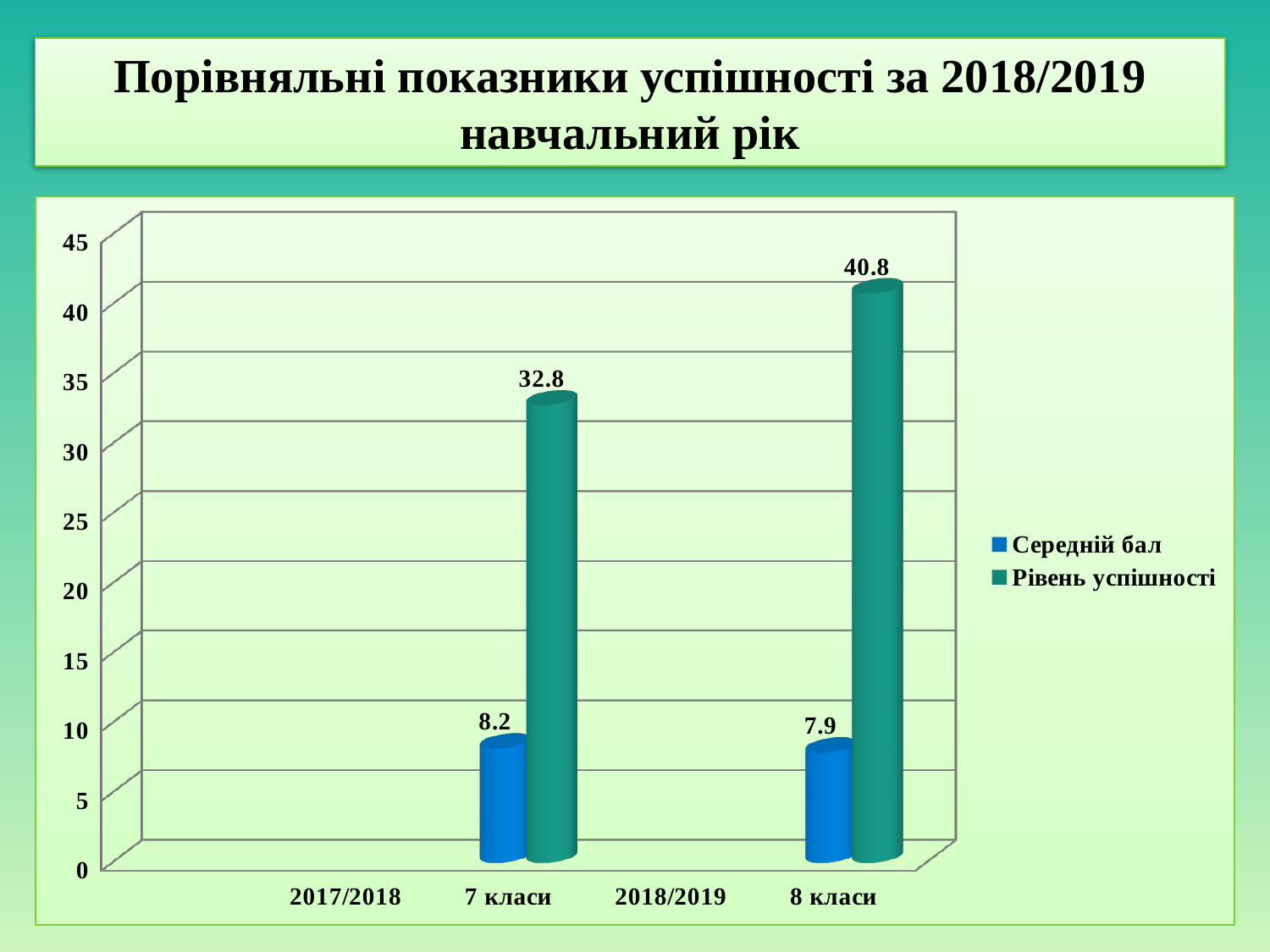
Which category has the highest Рівень успішності value? 8 класи Which is larger: Середній бал for 7 класи or Середній бал for 8 класи? 7 класи What kind of chart is shown on the slide? Bar chart Is the Рівень успішності value for 8 класи greater or less than 40? greater What is the value of Середній бал for 8 класи? 7.9 What is the value of Середній бал for 7 класи? 8.2 What is the value of Рівень успішності for 7 класи? 32.8 Which category has the lowest Середній бал value? 8 класи What is the difference between the Рівень успішності values for 8 класи and 7 класи? 8 What is the value of Рівень успішності for 8 класи? 40.8 What colour are the Середній бал bars? Blue How many series does the legend list? 2